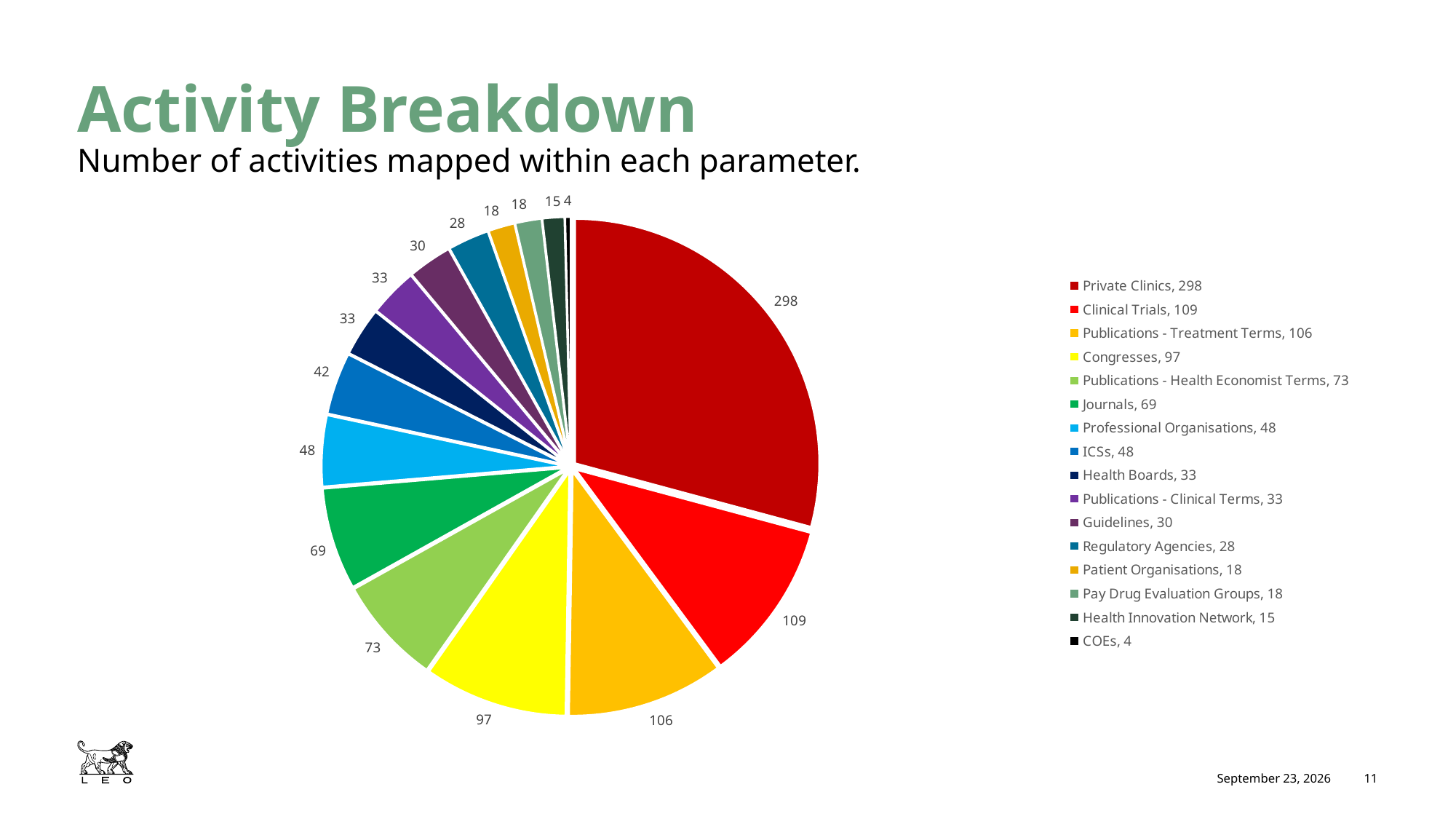
What is the value for Congresses? 97 How many activities are mapped for Private Clinics? 298 How many categories does the legend list? 16 What kind of chart is shown on the slide? pie chart Which category has the smallest slice of the pie? COEs Which category has the largest slice of the pie? Private Clinics What is the difference between the values for Private Clinics and Journals? 229 Which is larger, the value for Journals or the value for Professional Organisations? Journals What is the difference between the values for Clinical Trials and Publications - Treatment Terms? 3 What is the value for Guidelines? 30 What is the title of the chart slide? Activity Breakdown What is the value for Publications - Health Economist Terms? 73